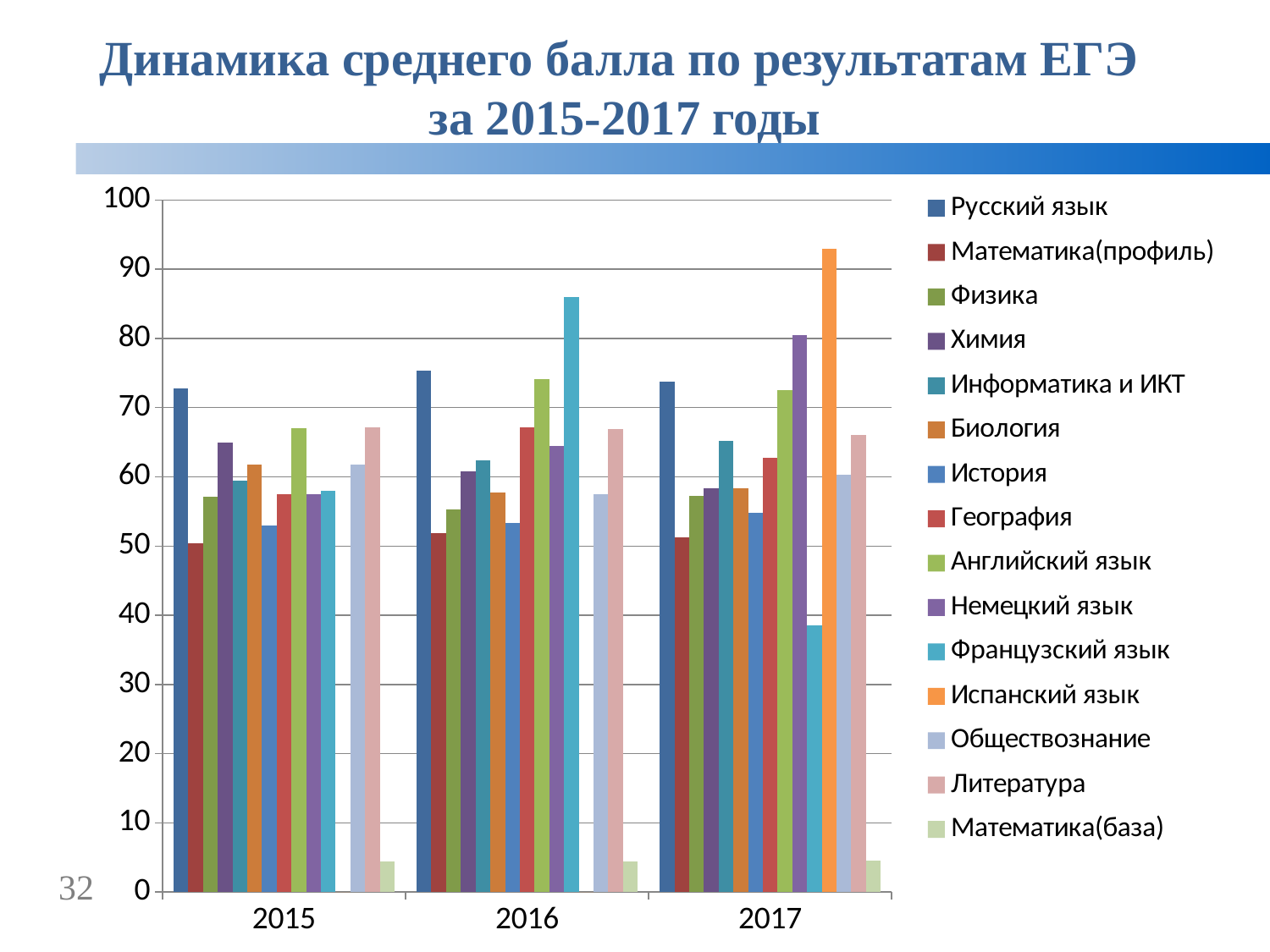
How many year categories are shown on the x axis? 3 Do the values for Немецкий язык rise or fall from 2015 to 2017? rise Which is larger for Французский язык: the value in 2016 or in 2017? 2016 Is the value for Французский язык in 2017 greater or less than 40? less What is the title of the chart on the slide? Динамика среднего балла по результатам ЕГЭ за 2015-2017 годы Is the value for Математика(профиль) in 2015 greater or less than 60? less Is the value for Испанский язык in 2017 greater or less than 90? greater Which subject has the lowest bar in 2016? Математика(база) Which subject has the highest bar in 2017? Испанский язык What kind of chart is shown on the slide? bar chart How many series does the legend list? 15